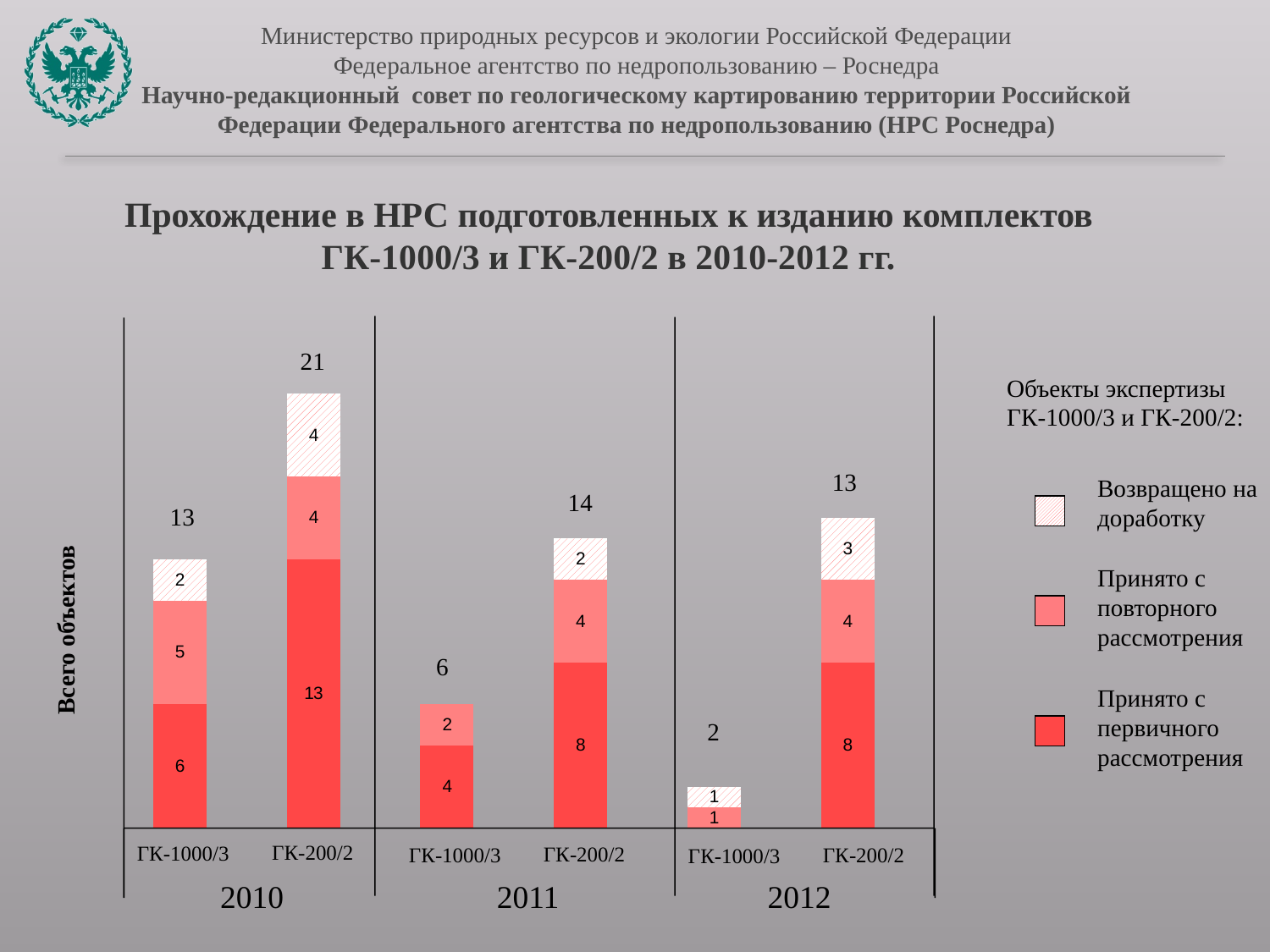
What is the total value printed above the ГК-200/2 bar for 2010? 21 What is the total value printed above the ГК-1000/3 bar for 2012? 2 Which bar has the lowest total value? ГК-1000/3 in 2012 In 2012, how many ГК-200/2 objects were returned for revision (Возвращено на доработку)? 3 In 2010, how many ГК-1000/3 objects were accepted after repeated review (Принято с повторного рассмотрения)? 5 How many bars are plotted in the chart? 6 In 2011, how many ГК-200/2 objects were accepted after primary review (Принято с первичного рассмотрения)? 8 Which bar has the highest total value? ГК-200/2 in 2010 Which is larger: the total for ГК-1000/3 in 2010 or the total for ГК-1000/3 in 2011? ГК-1000/3 in 2010 What is the difference between the total for ГК-200/2 in 2010 and the total for ГК-200/2 in 2011? 7 What kind of chart is shown on the slide? stacked bar chart How many entries does the legend list? 3